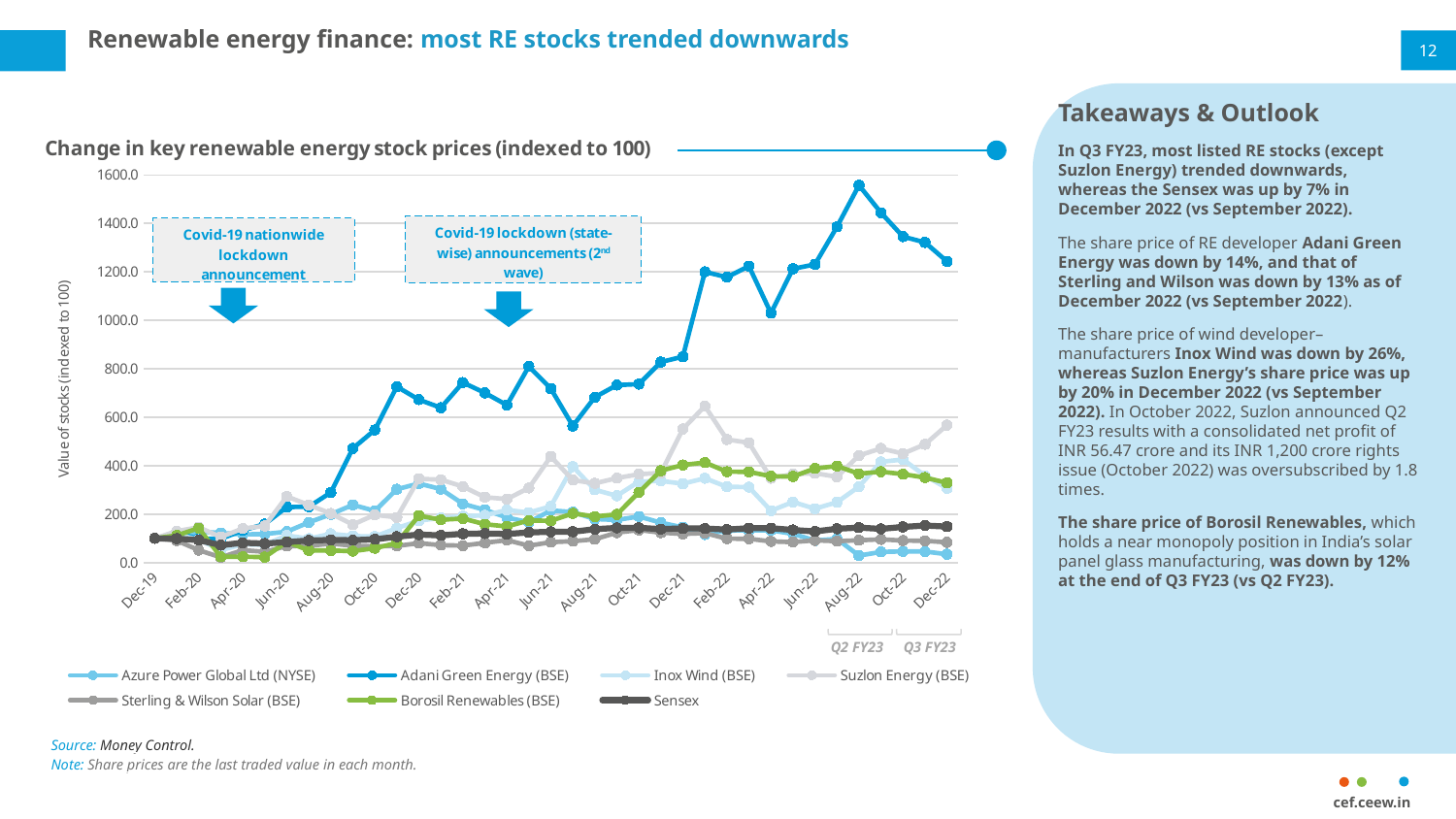
Is the value for Adani Green Energy (BSE) at Dec-22 greater or less than 1000? greater Does the Adani Green Energy (BSE) series rise or fall overall from Dec-19 to Aug-22? rise Which series has the lowest value at Dec-22? Azure Power Global Ltd (NYSE) Is the value for Suzlon Energy (BSE) at Dec-22 greater or less than 400? greater Which series has the highest value at Dec-22? Adani Green Energy (BSE) Is the value for Sensex at Dec-22 greater or less than 200? less At Dec-22, which is larger: Adani Green Energy (BSE) or Sensex? Adani Green Energy (BSE) How many series does the legend list? 7 What is the label of the vertical axis? Value of stocks (indexed to 100) What is the title of the chart? Change in key renewable energy stock prices (indexed to 100) What kind of chart is shown on the slide? Line chart